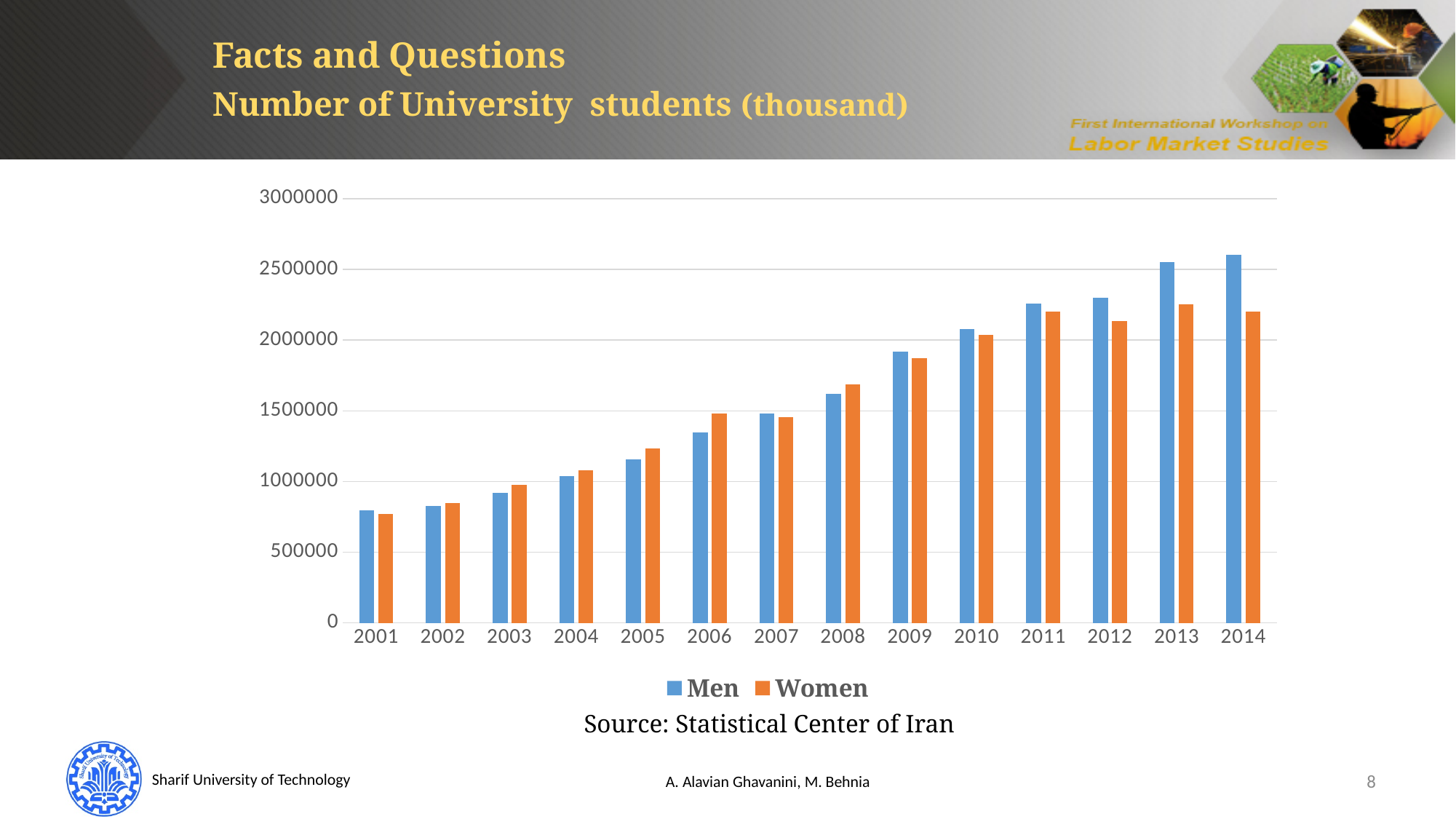
Is the value for Men in 2014 greater or less than 2500000? greater In 2006, which is larger, the value for Men or the value for Women? Women Which year has the highest value for Men? 2014 Which year has the lowest value for Men? 2001 Is the value for Women in 2008 greater or less than 1500000? greater How many years are shown on the x axis? 14 Is the value for Women in 2014 greater or less than 2500000? less In 2014, which is larger, the value for Men or the value for Women? Men How many series does the legend list? 2 What kind of chart is shown on the slide? bar chart Do the values for Men rise or fall from 2001 to 2014? rise